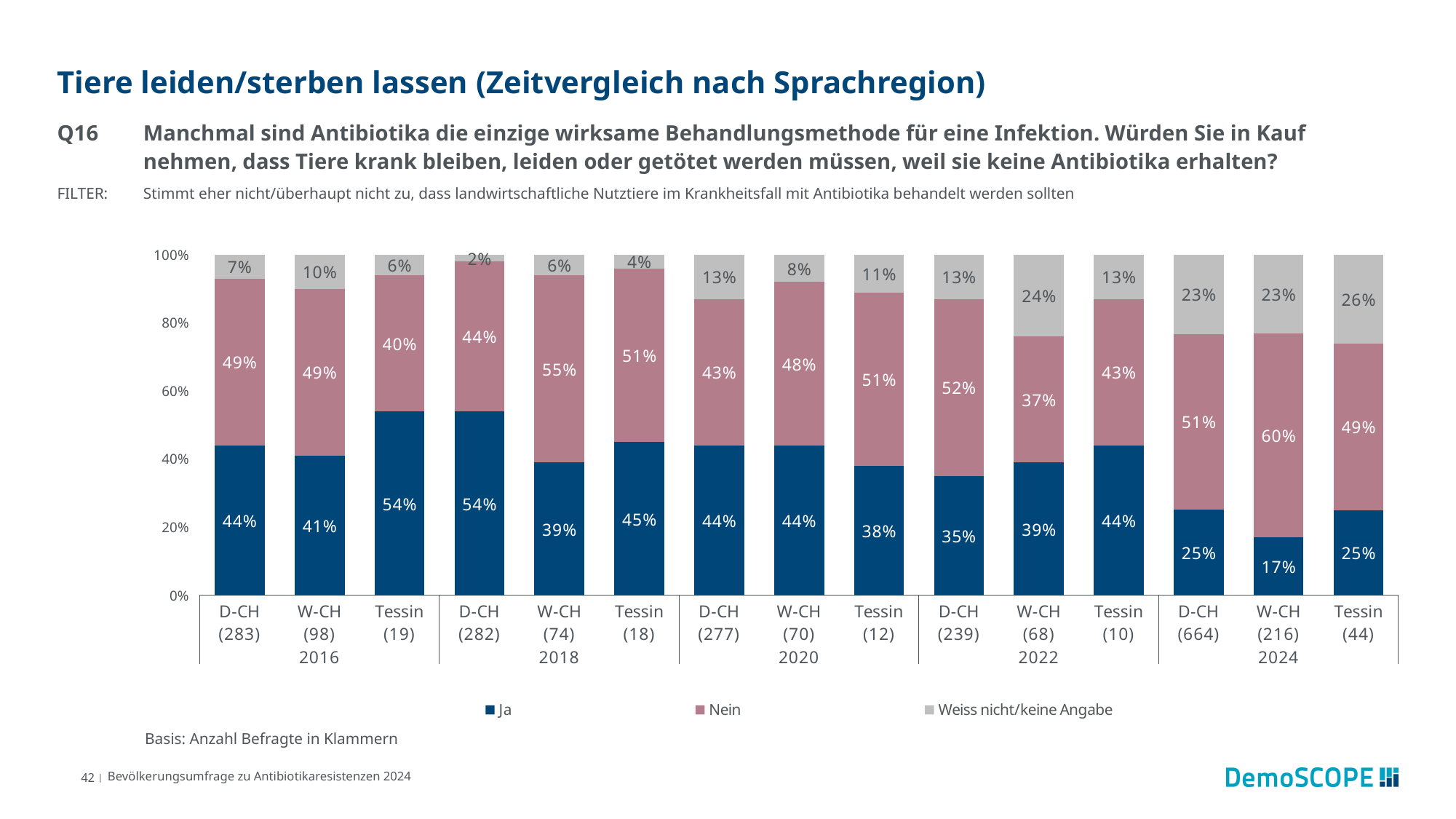
From 2020 to 2024, does the "Ja" share for D-CH rise or fall? Fall What is the "Nein" share for W-CH in 2024? 60% How many bars are shown in the chart? 15 By how many percentage points did the "Ja" share for D-CH fall from 2016 to 2024? 19 percentage points In 2022, which region had the larger "Ja" share, D-CH or W-CH? W-CH What kind of chart is shown on the slide? Stacked bar chart Which bar has the lowest "Weiss nicht/keine Angabe" share? D-CH 2018 (2%) Which bar has the highest "Weiss nicht/keine Angabe" share? Tessin 2024 (26%) How many series does the legend list? 3 Which bar has the lowest "Ja" share? W-CH 2024 (17%) What percentage of D-CH respondents in 2016 answered "Ja"? 44% What is the "Weiss nicht/keine Angabe" share for Tessin in 2024? 26%